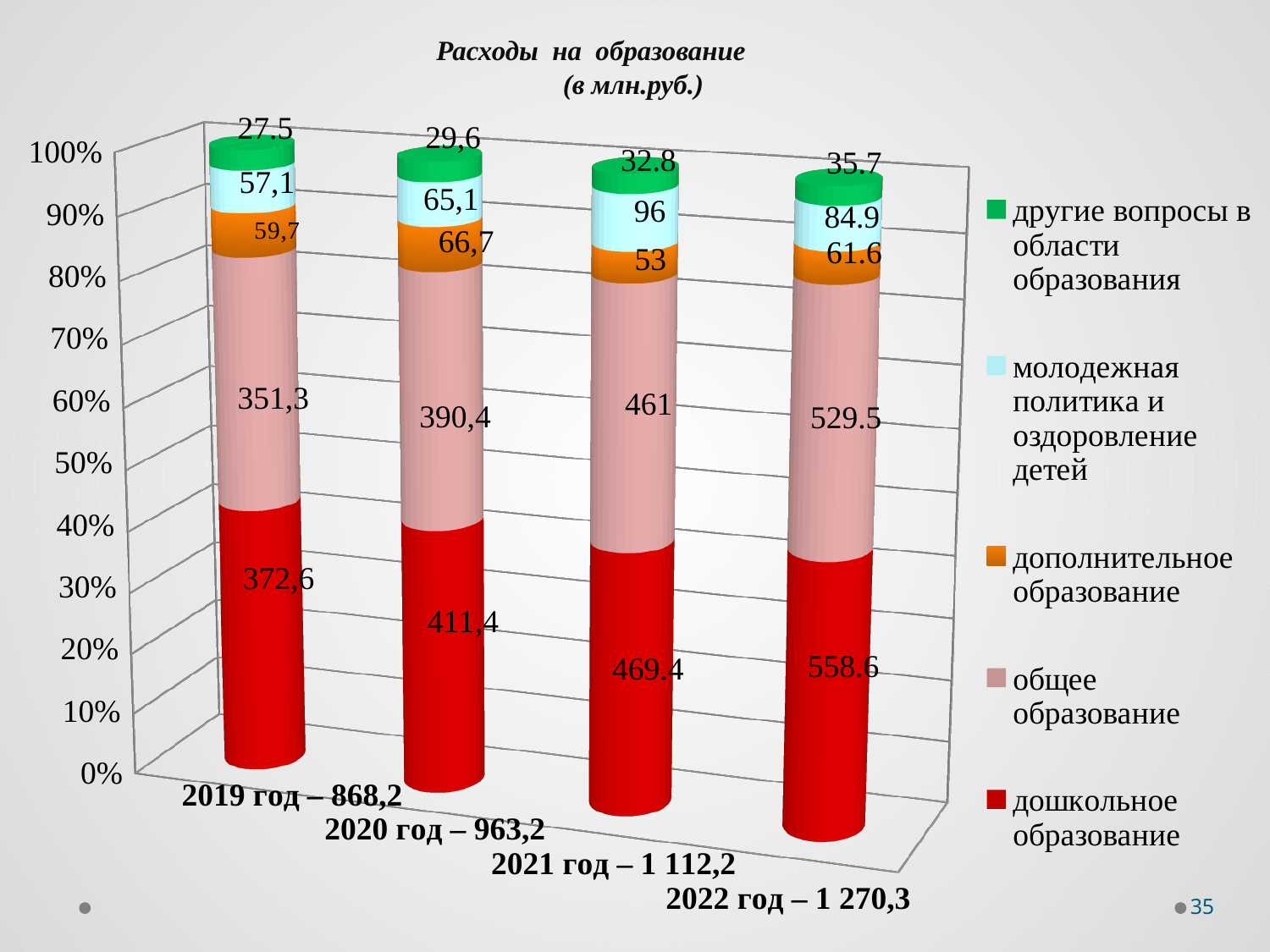
What is the value for молодежная политика и оздоровление детей in 2022? 84.9 What is the value for дошкольное образование in 2019? 372,6 What is the value for общее образование in 2021? 461 In 2022, what is the difference between дошкольное образование (558.6) and общее образование (529.5)? 29.1 In 2021, which is larger: молодежная политика и оздоровление детей or дополнительное образование? молодежная политика и оздоровление детей Does the value for дошкольное образование rise or fall from 2019 to 2022? rise How many series does the legend list? 5 What kind of chart is this? stacked bar chart In which year is the value for дошкольное образование the highest? 2022 What is the value for дополнительное образование in 2020? 66,7 In which year is the value for другие вопросы в области образования the lowest? 2019 How many years (bars) are shown on the chart? 4